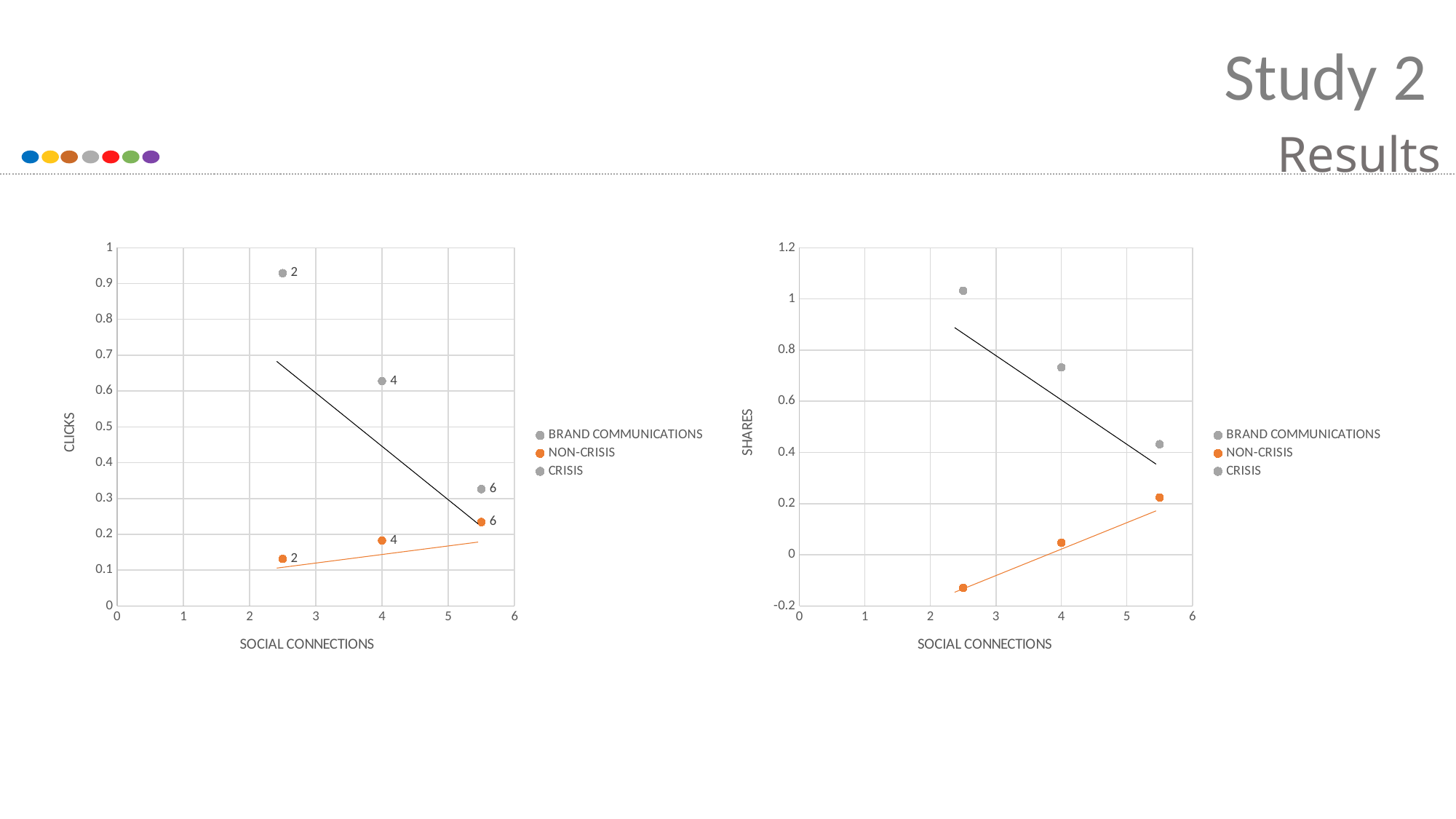
In the left chart (CLICKS), at the points labelled 4, which series has the higher value, CRISIS or NON-CRISIS? CRISIS In the right chart (SHARES), is the highest CRISIS point greater or less than 0.8? greater How many series does the legend of the left chart (CLICKS) list? 3 What kind of chart is the left chart (CLICKS vs SOCIAL CONNECTIONS)? scatter chart In the left chart (CLICKS), how many grey CRISIS points are plotted? 3 In the right chart (SHARES), do the CRISIS values rise or fall as social connections increase? fall In the left chart (CLICKS), do the NON-CRISIS values rise or fall as social connections increase? rise In the left chart (CLICKS), do the CRISIS values rise or fall as social connections increase? fall In the left chart (CLICKS), is the CRISIS point labelled 2 greater or less than 0.8? greater In the right chart (SHARES), is the lowest NON-CRISIS point greater or less than 0? less What is the y-axis title of the right chart? SHARES